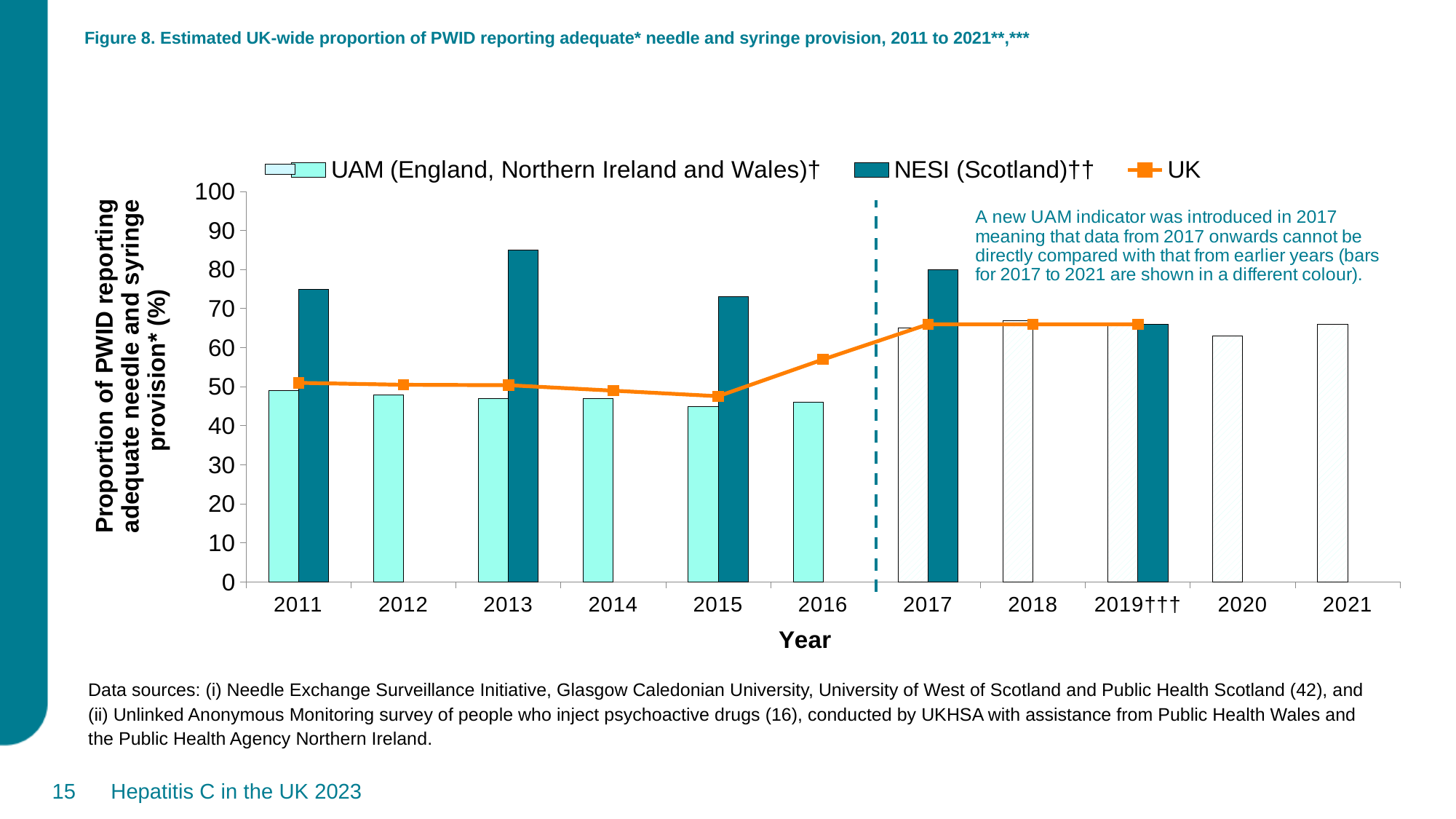
Does the UK line rise or fall between 2015 and 2017? Rises Is the UAM (England, Northern Ireland and Wales) value for 2015 greater or less than 50? less What is the label of the x axis? Year Is the NESI (Scotland) value for 2013 greater or less than 80? greater In how many years is a NESI (Scotland) bar plotted? 5 What kind of chart is shown on the slide? A bar chart combined with a line chart In which year is the NESI (Scotland) bar lowest? 2019††† In which year is the NESI (Scotland) bar highest? 2013 How many years are shown on the x axis? 11 Is the UK value for 2016 greater or less than 50? greater How many series does the legend list? 3 In 2011, which is larger: the UAM (England, Northern Ireland and Wales) bar or the NESI (Scotland) bar? NESI (Scotland)